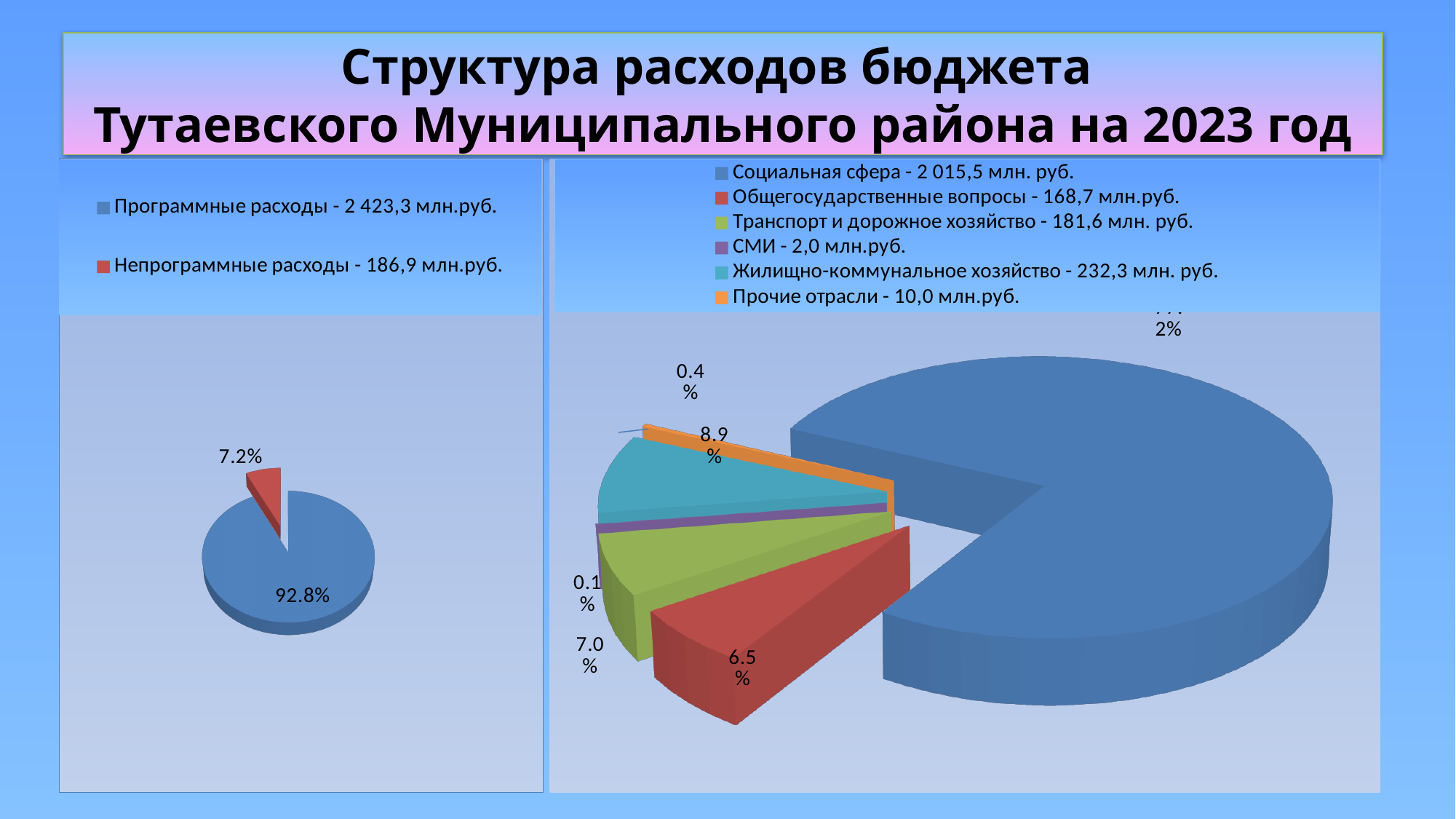
In the right pie chart, which category has the smallest value? СМИ In the left pie chart, what is the value of Непрограммные расходы according to the legend? 186,9 млн.руб. What kind of chart is shown on the left side of the slide? pie chart In the left pie chart, what share does Непрограммные расходы have? 7.2% In the left pie chart, what share does Программные расходы have? 92.8% In the right pie chart, what is the value of Жилищно-коммунальное хозяйство according to the legend? 232,3 млн. руб. In the right pie chart, what is the value of СМИ according to the legend? 2,0 млн.руб. In the right pie chart, what share is labelled on the red slice (Общегосударственные вопросы)? 6.5% In the right pie chart, which category has the largest value? Социальная сфера In the right pie chart, which is larger: Транспорт и дорожное хозяйство or Общегосударственные вопросы? Транспорт и дорожное хозяйство How many categories does the legend of the right pie chart list? 6 In the left pie chart, what is the value of Программные расходы according to the legend? 2 423,3 млн.руб.